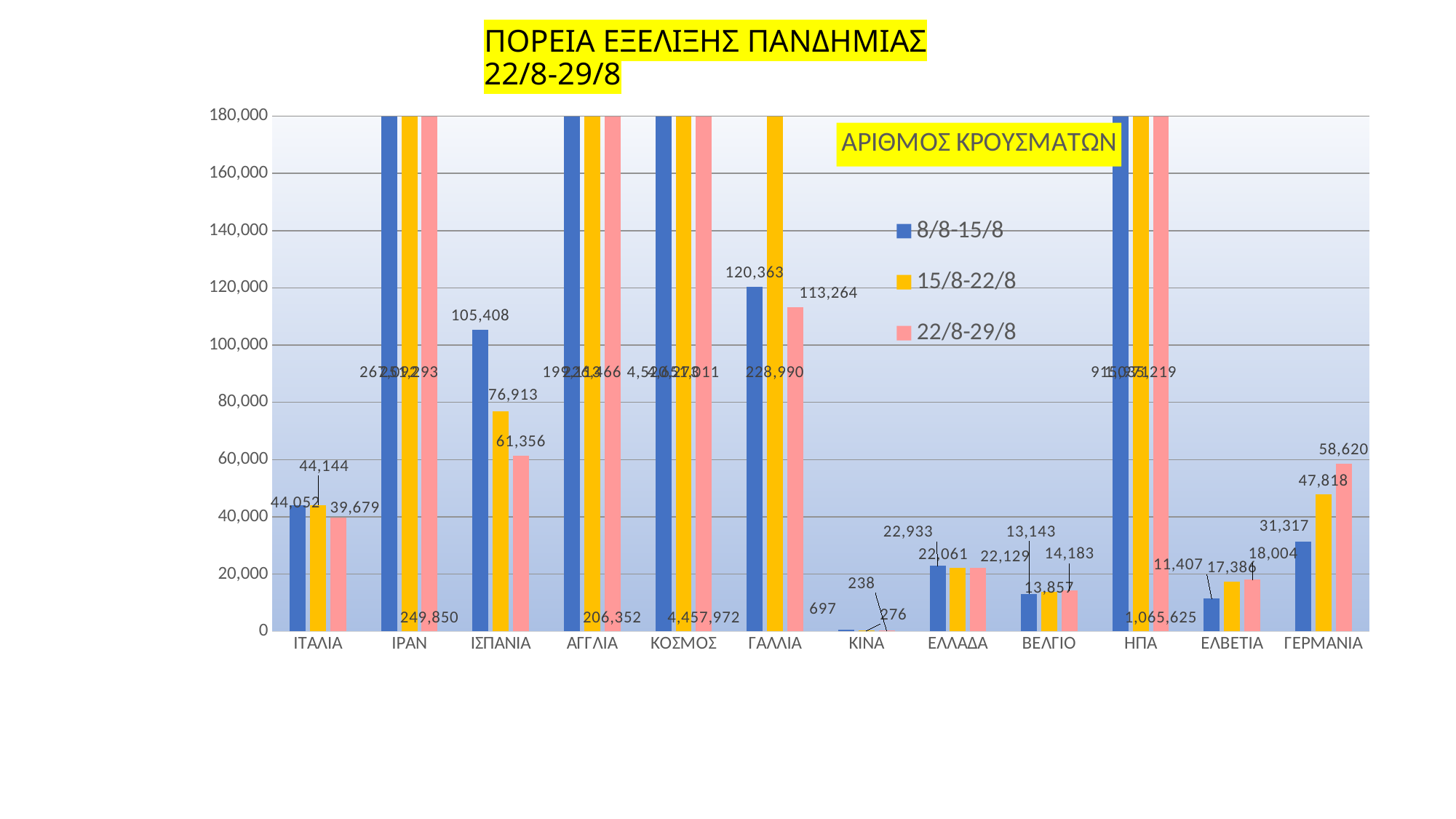
What is the value for ΓΕΡΜΑΝΙΑ in the 22/8-29/8 series? 58,620 How many series does the legend list? 3 What is the difference between the 22/8-29/8 and 15/8-22/8 values for ΓΕΡΜΑΝΙΑ? 10,802 What is the value for ΙΣΠΑΝΙΑ in the 8/8-15/8 series? 105,408 What is the difference between the 8/8-15/8 and 22/8-29/8 values for ΙΣΠΑΝΙΑ? 44,052 How many countries/categories are shown on the x axis? 12 What is the value for ΚΙΝΑ in the 8/8-15/8 series? 697 For ΙΤΑΛΙΑ, which is larger: the 15/8-22/8 value or the 22/8-29/8 value? 15/8-22/8 Which series has the lowest value for ΕΛΒΕΤΙΑ? 8/8-15/8 What is the value for ΓΑΛΛΙΑ in the 22/8-29/8 series? 113,264 Do the values for ΓΕΡΜΑΝΙΑ rise or fall from the 8/8-15/8 series to the 22/8-29/8 series? rise What kind of chart is shown on the slide? bar chart